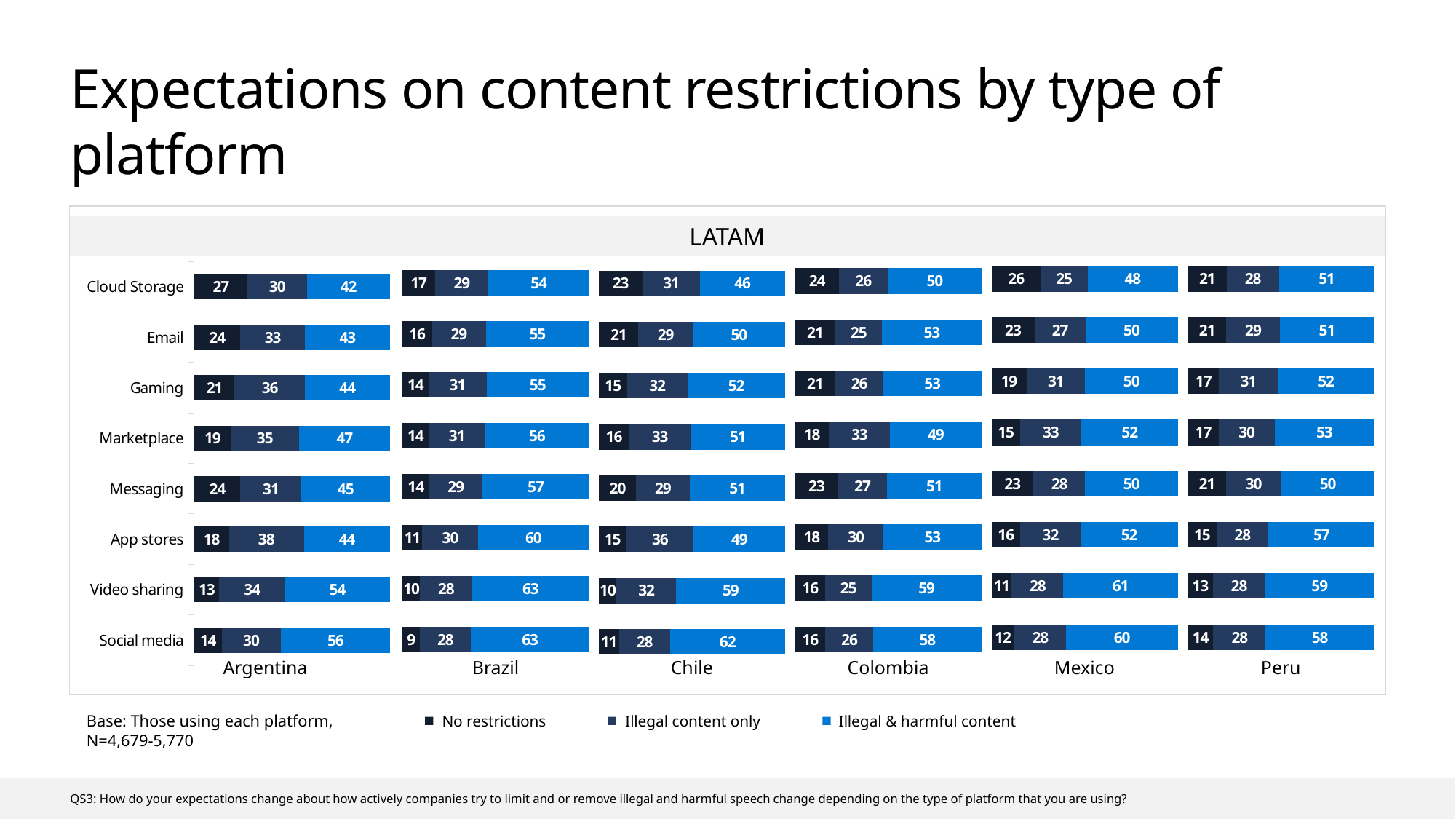
What is the 'Illegal & harmful content' value for Social media in Argentina? 56 What is the difference between the 'Illegal & harmful content' value for Cloud Storage in Brazil and in Argentina? 12 How many platform categories are listed on the vertical axis? 8 What is the 'Illegal & harmful content' value for App stores in Peru? 57 How many countries are shown along the bottom of the chart? 6 How many series does the legend list? 3 Which is larger: the 'Illegal content only' value for Gaming in Colombia or in Peru? Peru In Mexico, which platform has the lowest 'No restrictions' value? Video sharing What is the total of the stacked bar for Cloud Storage in Argentina? 99 In Chile, which platform has the highest 'Illegal & harmful content' value? Social media What kind of chart is shown on the slide? Stacked bar chart What is the 'No restrictions' value for App stores in Brazil? 11